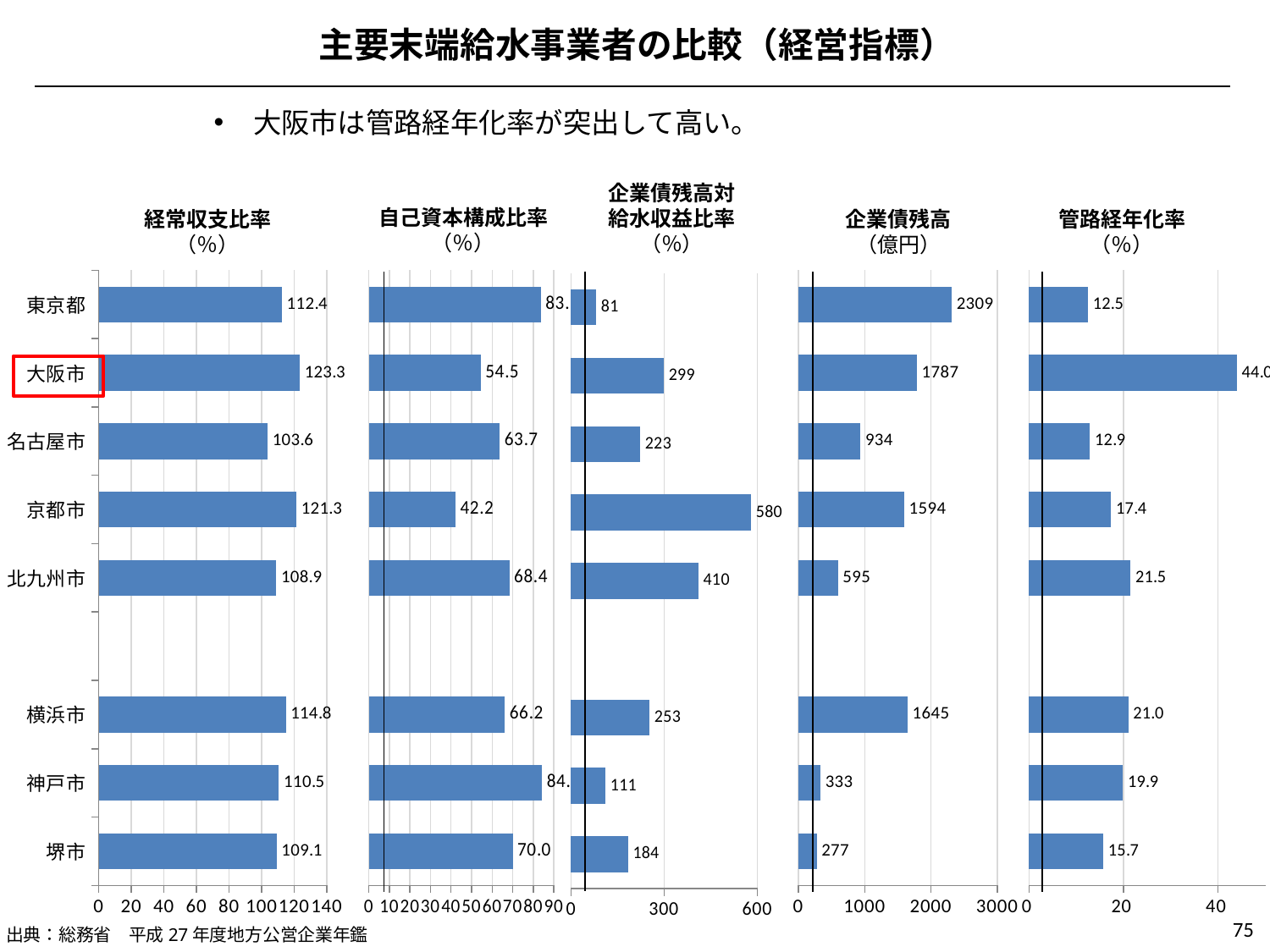
In the 自己資本構成比率 (%) chart, which is larger, 名古屋市 or 京都市? 名古屋市 In the 管路経年化率 (%) chart, which city has the highest value? 大阪市 How many cities are plotted in the 経常収支比率 (%) chart? 8 In the 企業債残高対給水収益比率 (%) chart, what is the value for 北九州市? 410 In the 企業債残高 (億円) chart, what is the difference between 東京都 and 大阪市? 522 In the 自己資本構成比率 (%) chart, which city has the lowest value? 京都市 In the 経常収支比率 (%) chart, which city has the highest value? 大阪市 In the 企業債残高 (億円) chart, which city has the lowest value? 堺市 In the 経常収支比率 (%) chart, what is the value for 大阪市? 123.3 In the 企業債残高対給水収益比率 (%) chart, which city has the highest value? 京都市 In the 企業債残高 (億円) chart, what is the value for 東京都? 2309 In the 管路経年化率 (%) chart, what is the value for 北九州市? 21.5